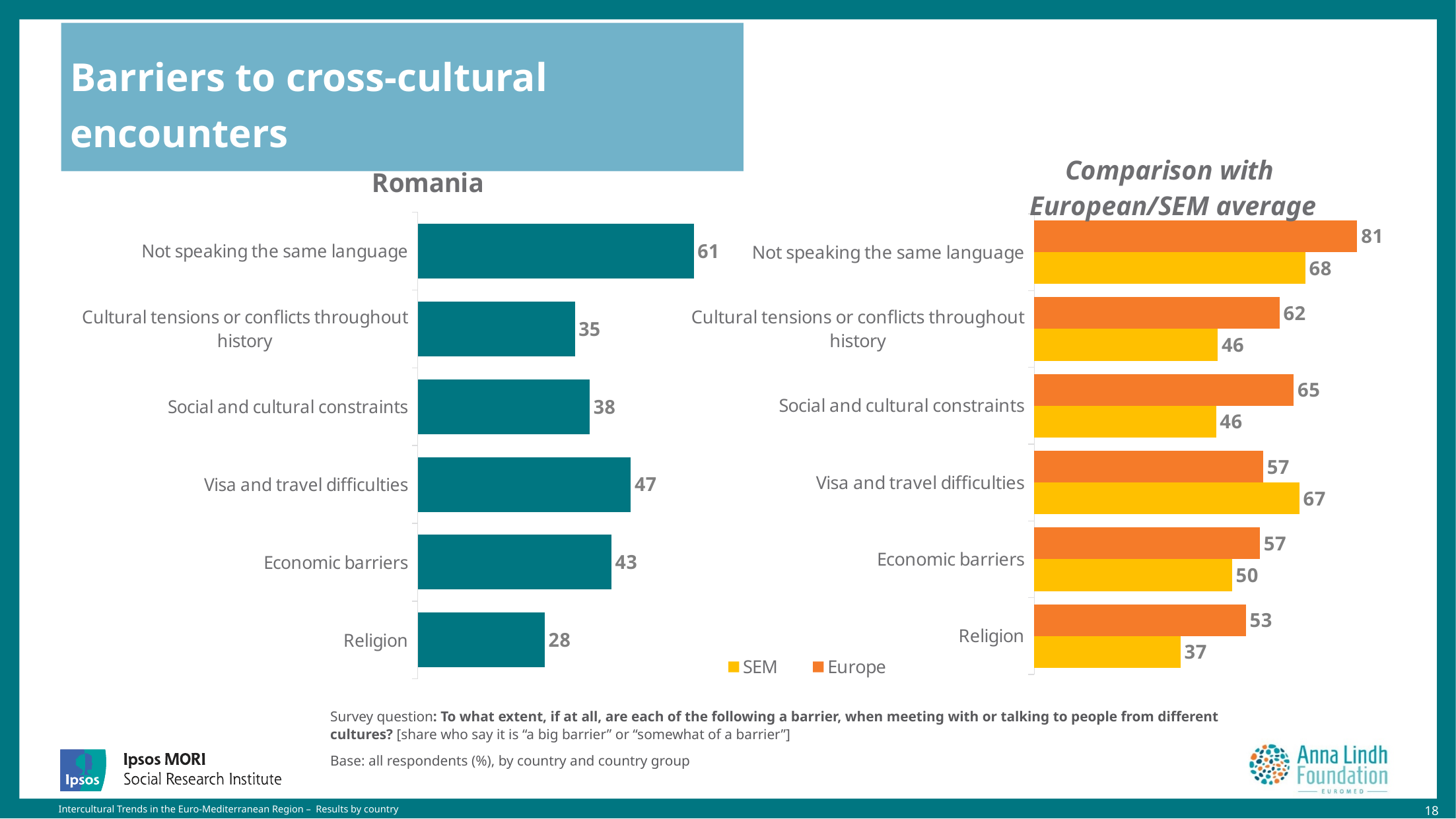
In the Comparison with European/SEM average chart, what is the Europe value for Not speaking the same language? 81 In the Comparison with European/SEM average chart, what is the difference between the Europe and SEM values for Cultural tensions or conflicts throughout history? 16 In the Romania chart, what is the value for Not speaking the same language? 61 In the Romania chart, what is the difference between Visa and travel difficulties and Economic barriers? 4 In the Romania chart, which barrier has the lowest value? Religion How many series does the legend of the Comparison with European/SEM average chart list? 2 In the Romania chart, which barrier has the highest value? Not speaking the same language What type of chart is the Romania chart? Bar chart In the Comparison with European/SEM average chart, what is the SEM value for Visa and travel difficulties? 67 In the Comparison with European/SEM average chart, which is larger for Religion, the SEM value or the Europe value? Europe In the Romania chart, what is the value for Religion? 28 In the Romania chart, how many barriers are shown? 6